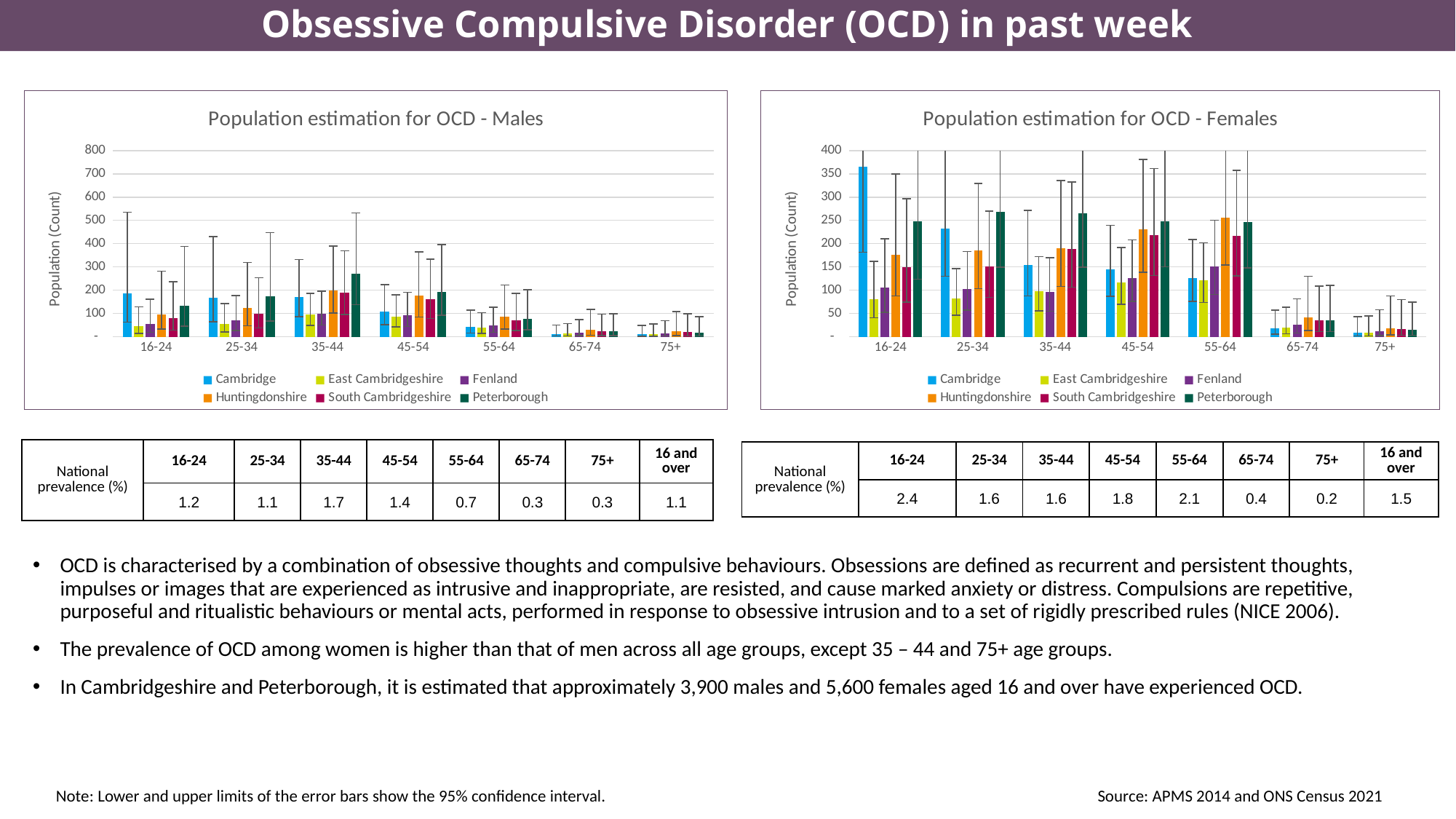
In the 'Population estimation for OCD - Females' chart, is the Cambridge value for 16-24 greater or less than 300? greater In the 'Population estimation for OCD - Males' chart, do the Cambridge bars rise or fall from 45-54 to 75+? Fall In the 'Population estimation for OCD - Females' chart, which is larger for 16-24: Cambridge or Peterborough? Cambridge What is the y-axis label of the 'Population estimation for OCD - Males' chart? Population (Count) In the 'Population estimation for OCD - Males' chart, which area has the highest bar in the 35-44 age group? Peterborough What type of chart is the 'Population estimation for OCD - Males' chart? Bar chart In the 'Population estimation for OCD - Females' chart, is the Peterborough value for 65-74 greater or less than 100? less How many series does the legend of the 'Population estimation for OCD - Males' chart list? 6 In the 'Population estimation for OCD - Males' chart, is the Peterborough value for 35-44 greater or less than 200? greater In the 'Population estimation for OCD - Females' chart, which is larger for 55-64: Huntingdonshire or East Cambridgeshire? Huntingdonshire How many age group categories are shown on the x axis of the 'Population estimation for OCD - Females' chart? 7 In the 'Population estimation for OCD - Females' chart, which age group has the highest Cambridge bar? 16-24